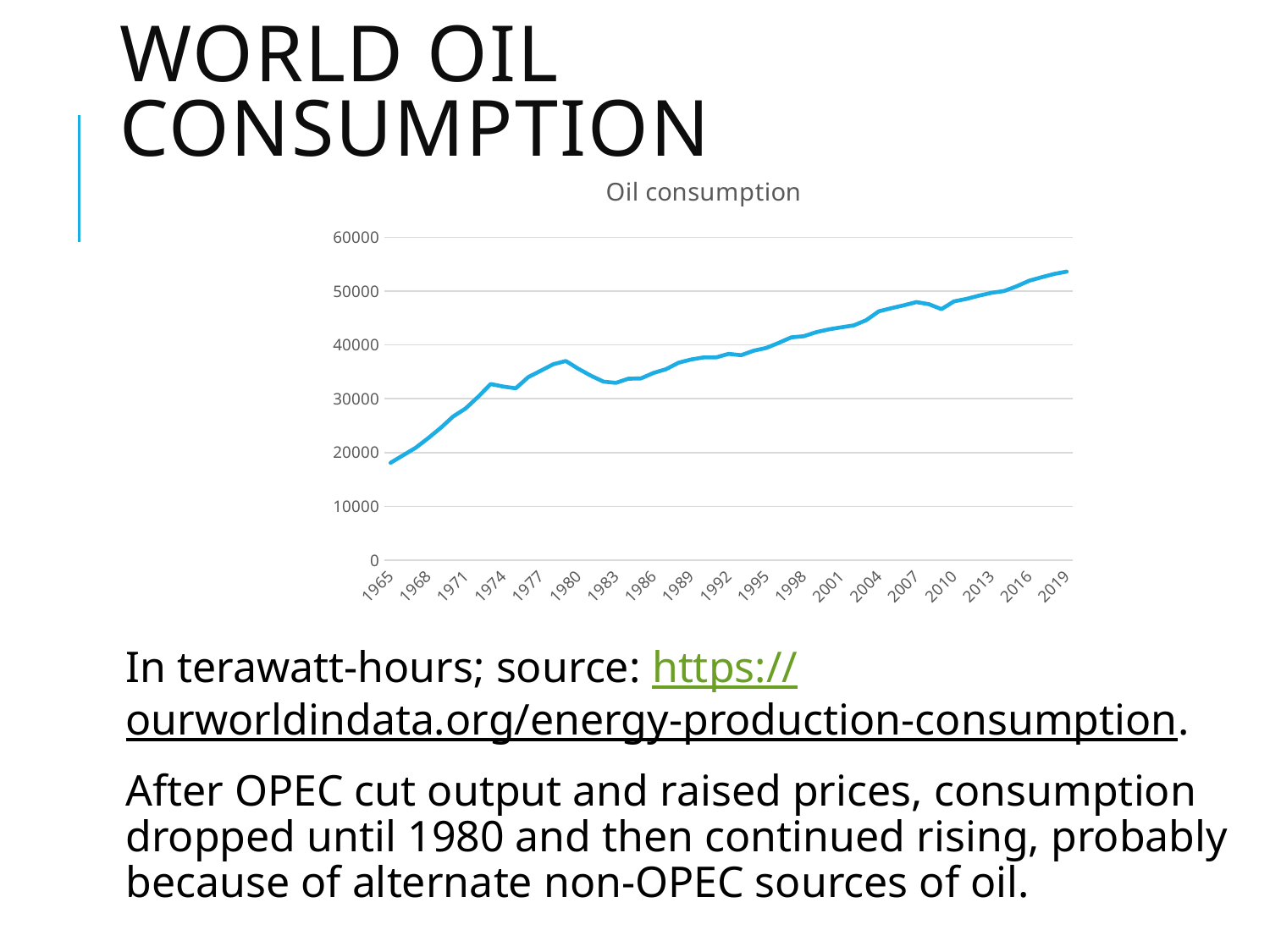
How many year labels are shown on the x axis? 19 Is the value for 1965 greater or less than 20000? less Which is larger, the value for 1974 or the value for 1977? 1977 Overall, do the values rise or fall from 1965 to 2019? rise Which is larger, the value for 1980 or the value for 1983? 1980 What is the title of the chart? Oil consumption Is the value for 2004 greater or less than 40000? greater Which year has the highest oil consumption value on the chart? 2019 Which year has the lowest oil consumption value on the chart? 1965 Is the value for 1980 greater or less than 40000? less What kind of chart is shown on the slide? line chart